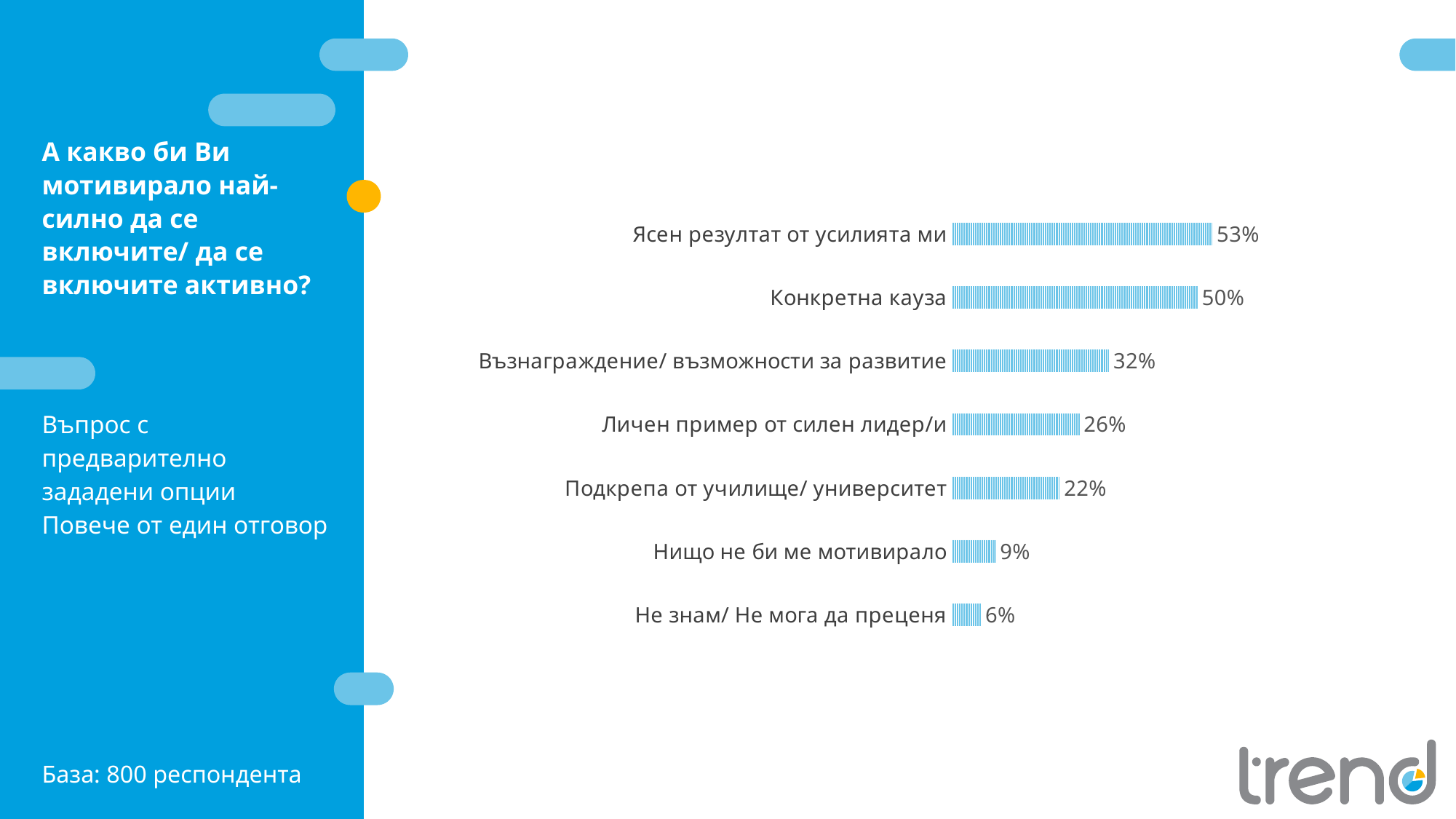
What is the difference between the values for "Ясен резултат от усилията ми" and "Конкретна кауза"? 3% How many categories are shown in the chart? 7 What kind of chart is shown on the slide? Bar chart What is the difference between the values for "Лични пример от силен лидер/и" and "Нищо не би ме мотивирало"? 17% What value is shown for "Ясен резултат от усилията ми"? 53% What value is shown for "Възнаграждение/ възможности за развитие"? 32% Which is larger: the value for "Възнаграждение/ възможности за развитие" or the value for "Личен пример от силен лидер/и"? Възнаграждение/ възможности за развитие What value is shown for "Конкретна кауза"? 50% Which category has the lowest value? Не знам/ Не мога да преценя What is the base (number of respondents) stated on the slide? 800 респондента What value is shown for "Подкрепа от училище/ университет"? 22% Which category has the highest value? Ясен резултат от усилията ми